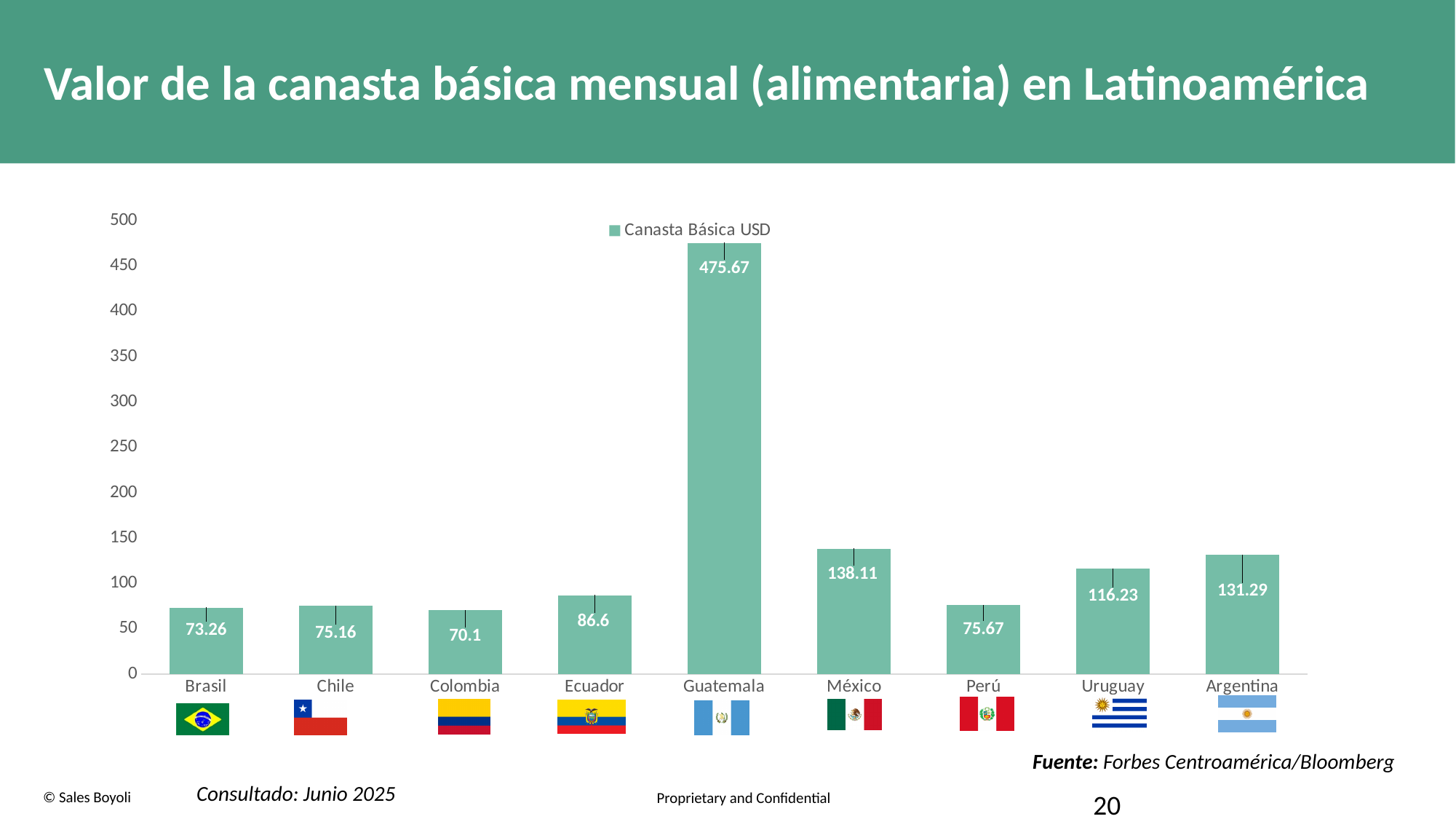
Which country has the highest value? Guatemala What is the value for México? 138.11 What kind of chart is shown? bar chart How many countries are shown on the chart? 9 How many series does the legend list? 1 What is the value for Guatemala? 475.67 Which country has the lowest value? Colombia Which is larger, the value for Ecuador or the value for Perú? Ecuador What is the difference between the values for Argentina and Uruguay? 15.06 What is the value for Colombia? 70.1 Is the value for Uruguay greater or less than 100? greater What is the legend entry for the series? Canasta Básica USD